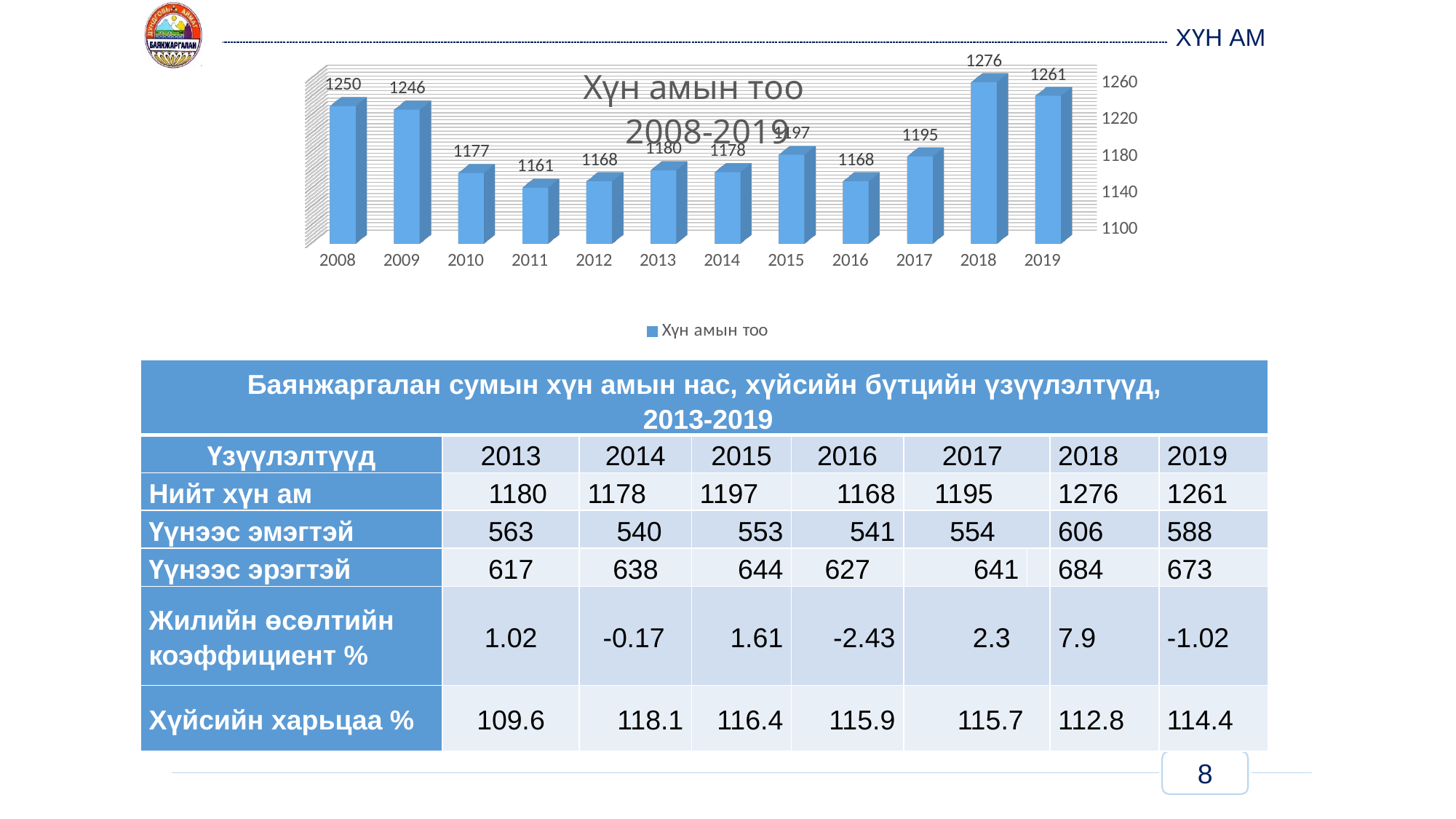
What is the title of the chart? Хүн амын тоо 2008-2019 What is the difference between the values for 2018 and 2019 in the chart? 15 What is the value for 2018 in the chart? 1276 How many years are shown on the x axis of the chart? 12 How many series does the chart legend list? 1 What is the value for 2008 in the chart? 1250 What is the value for 2011 in the chart? 1161 Which year has the lowest value in the chart? 2011 Which is larger in the chart, the value for 2008 or the value for 2009? 2008 Which year has the highest value in the chart? 2018 Is the value for 2015 in the chart greater or less than 1180? greater What type of chart is shown on the slide? bar chart